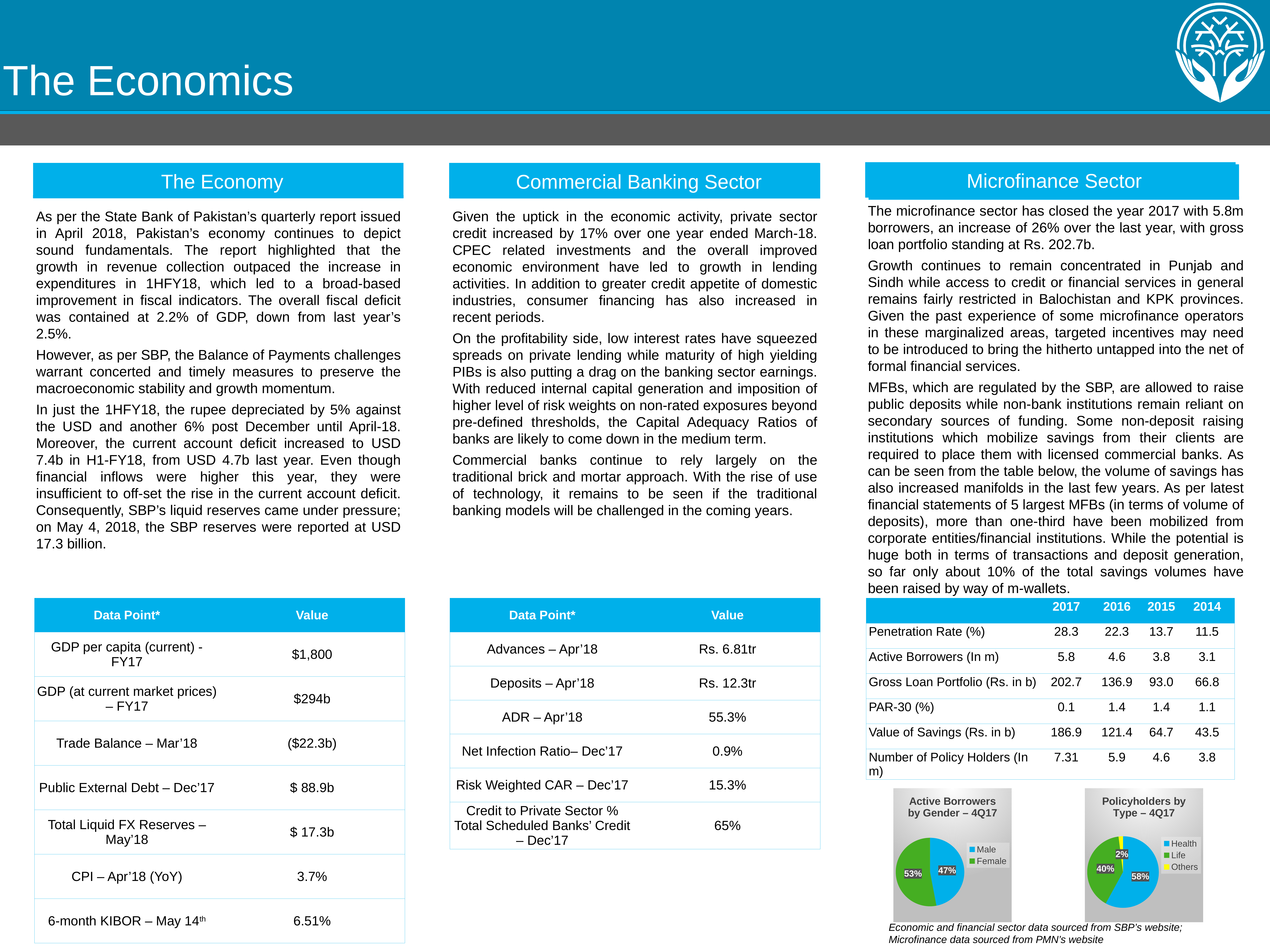
In the 'Active Borrowers by Gender – 4Q17' chart, what share of active borrowers is Male? 47% In the 'Policyholders by Type – 4Q17' chart, which type has the smallest share? Others How many series does the legend of the 'Active Borrowers by Gender – 4Q17' chart list? 2 What type of chart is 'Active Borrowers by Gender – 4Q17'? Pie chart In the 'Policyholders by Type – 4Q17' chart, what share of policyholders is Health? 58% How many categories does the 'Policyholders by Type – 4Q17' pie chart show? 3 In the 'Active Borrowers by Gender – 4Q17' chart, what share of active borrowers is Female? 53% In the 'Active Borrowers by Gender – 4Q17' chart, what is the difference in percentage points between the Female and Male shares? 6 percentage points In the 'Policyholders by Type – 4Q17' chart, which is larger, the Health share or the Life share? Health In the 'Active Borrowers by Gender – 4Q17' chart, which gender has the larger share? Female In the 'Policyholders by Type – 4Q17' chart, what share of policyholders is Life? 40% In the 'Policyholders by Type – 4Q17' chart, what share of policyholders is Others? 2%